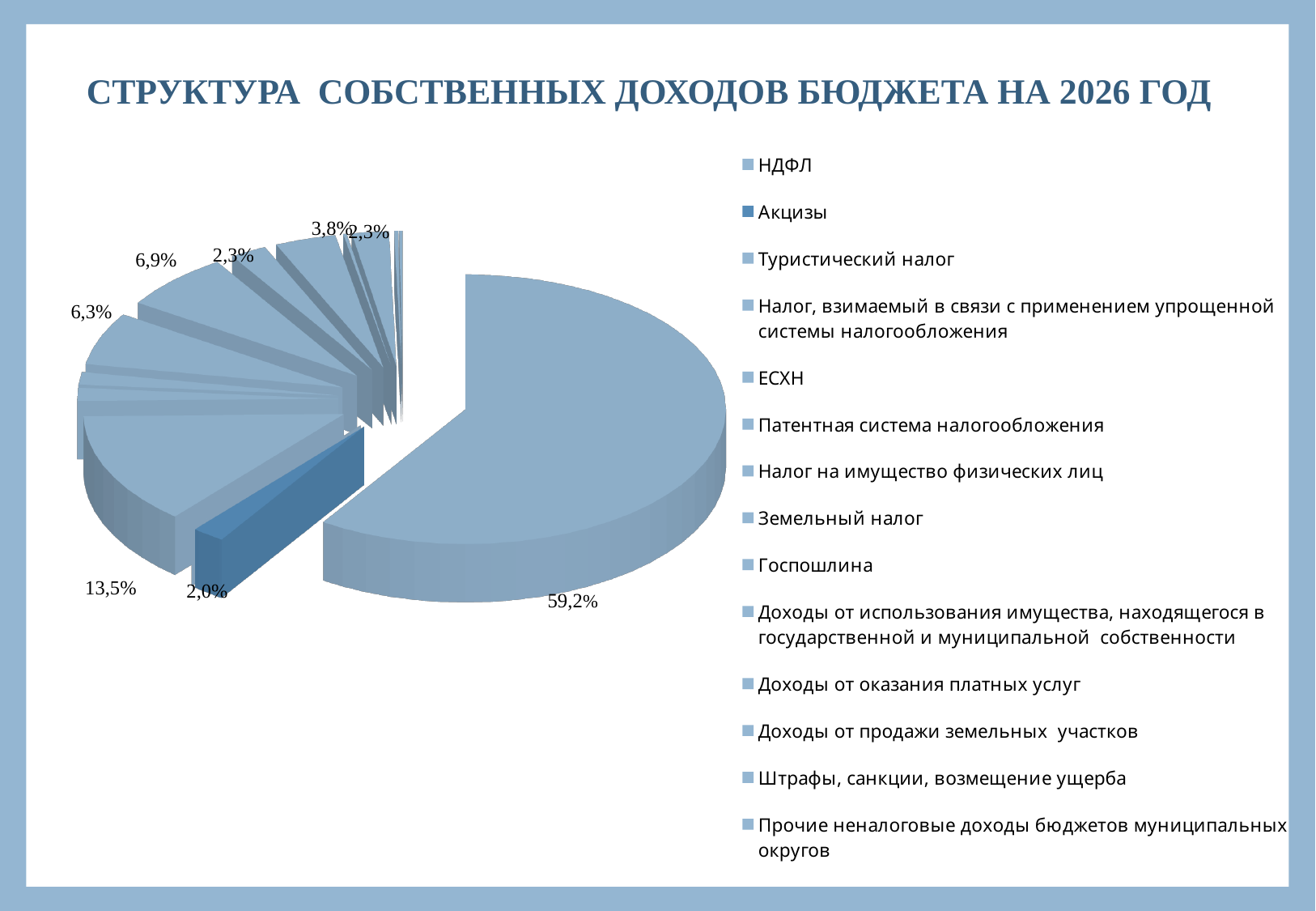
What kind of chart is shown on the slide? pie chart What is the smallest value printed as a data label on the pie chart? 2,0% Which is larger on the pie chart: the slice labelled 13,5% or the slice labelled 6,9%? 13,5% Is the share for НДФЛ greater or less than 50%? greater What share of the pie does НДФЛ account for? 59,2% What is the title of the chart on the slide? СТРУКТУРА СОБСТВЕННЫХ ДОХОДОВ БЮДЖЕТА НА 2026 ГОД What share of the pie does Акцизы account for? 2,0% Which legend entry is drawn in a darker blue than the other slices? Акцизы What is the difference between the slice labelled 6,9% and the slice labelled 6,3%? 0,6% What is the largest share shown on the pie chart? 59,2% What is the difference between the slice labelled 59,2% and the slice labelled 13,5%? 45,7% How many entries does the legend of the pie chart list? 14